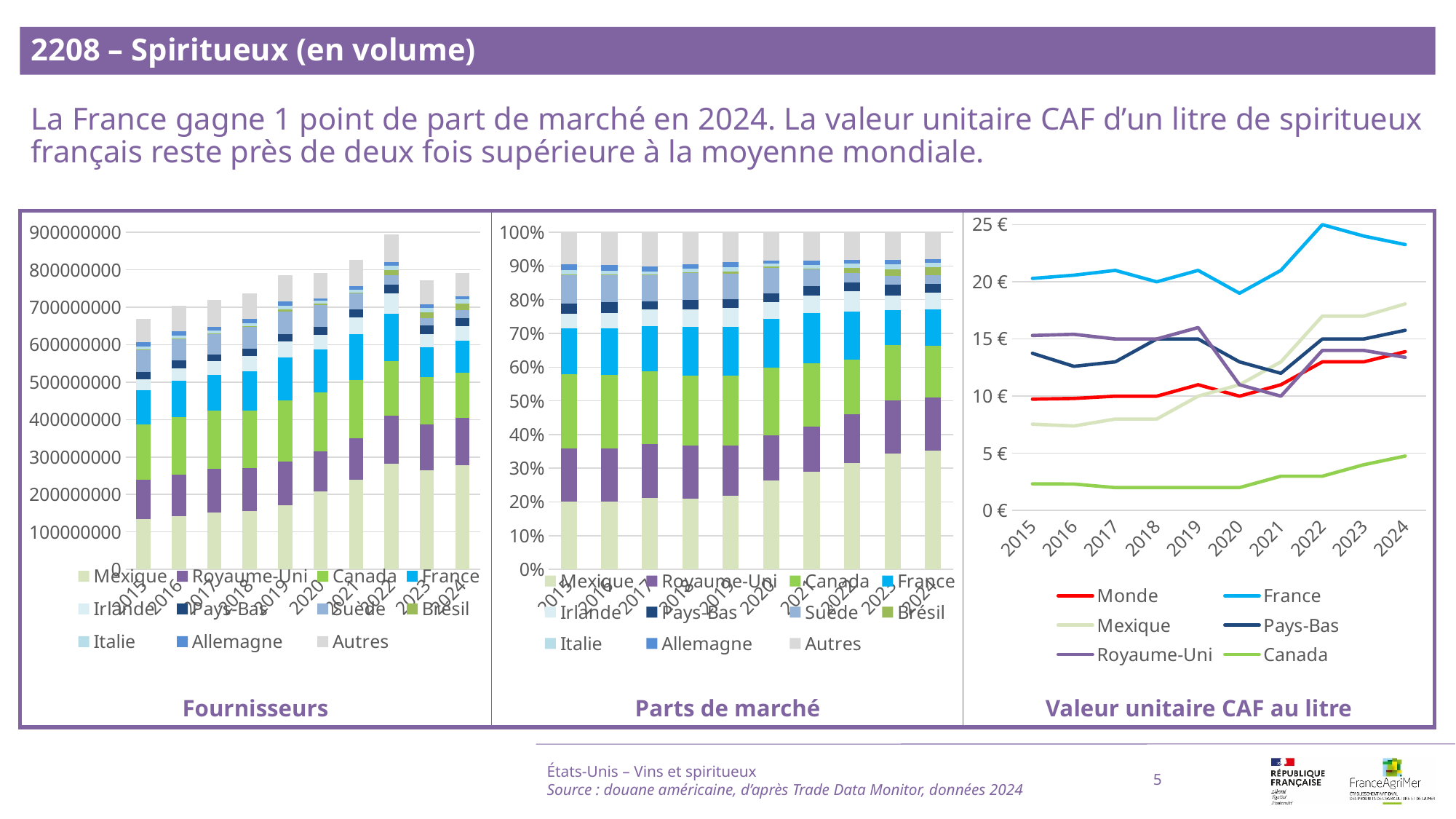
What kind of chart is the 'Fournisseurs' chart? bar chart How many years are shown on the x axis of the 'Parts de marché' chart? 10 How many series does the legend of the 'Valeur unitaire CAF au litre' chart list? 6 In the 'Fournisseurs' chart, which year has the highest total stacked bar? 2022 In the 'Valeur unitaire CAF au litre' chart, is the value for France in 2022 greater or less than 20 €? greater What kind of chart is the 'Valeur unitaire CAF au litre' chart? line chart In the 'Parts de marché' chart, is the share for Mexique in 2015 greater or less than 30%? less How many series does the legend of the 'Fournisseurs' chart list? 11 In the 'Valeur unitaire CAF au litre' chart, which series has the lowest value in 2024? Canada In the 'Valeur unitaire CAF au litre' chart, does the Canada line rise or fall from 2015 to 2024? rise In the 'Valeur unitaire CAF au litre' chart, which series has the highest value in 2024? France In the 'Fournisseurs' chart, is the total for 2022 greater or less than 800000000? greater